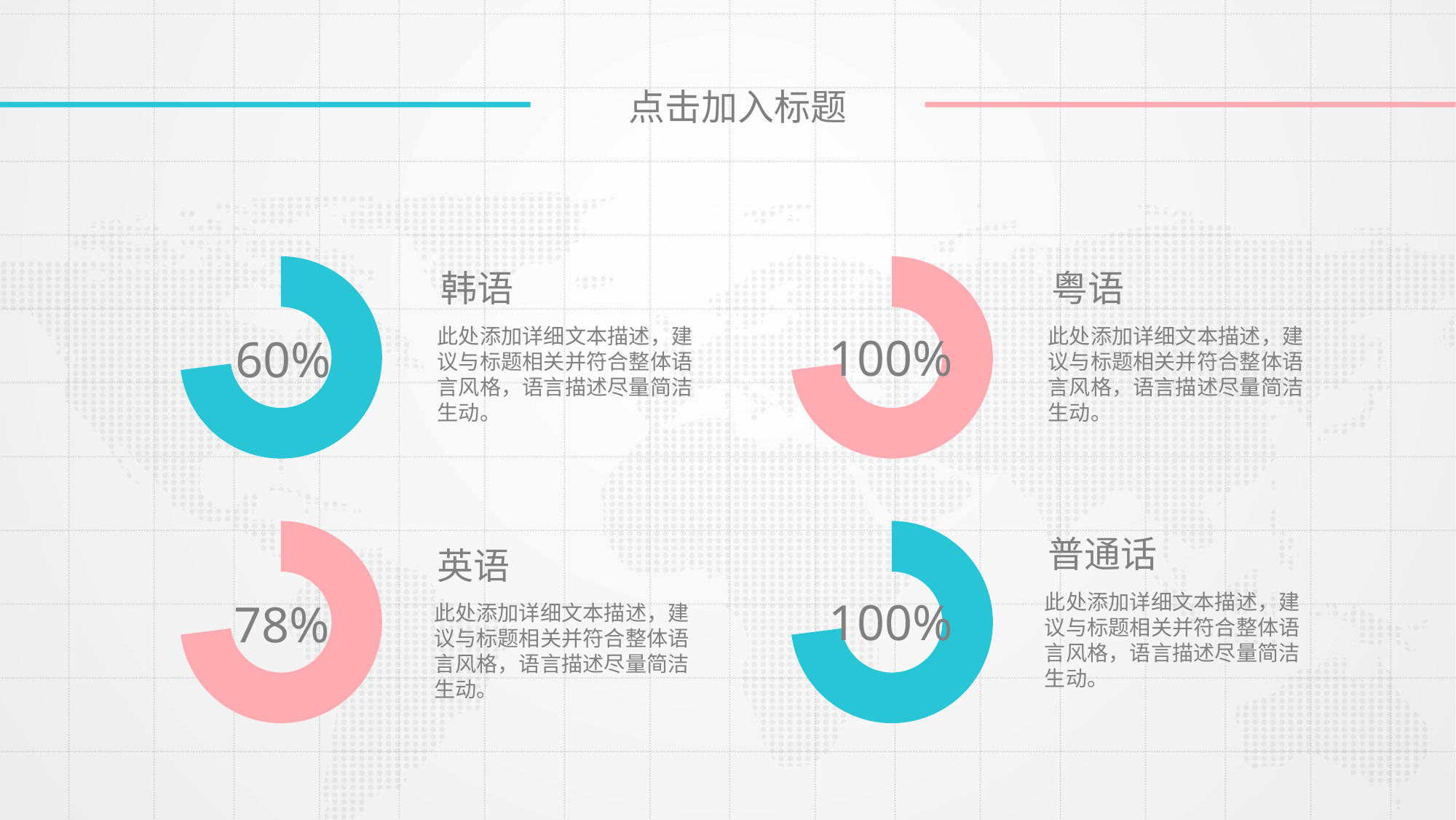
What colour is the ring chart for 英语? Pink What percentage is shown for 普通话? 100% What is the difference between the percentages for 粤语 and 英语? 22% What kind of chart is used for each language on the slide? Donut (ring) chart How many ring charts are on the slide? 4 What percentage is shown for 英语? 78% What percentage is shown for 粤语? 100% How many languages show a value of 100%? 2 Which is larger, the percentage for 英语 or the percentage for 韩语? 英语 Which language has the lowest percentage on the slide? 韩语 What is the difference between the percentages for 英语 and 韩语? 18% What percentage is shown for 韩语? 60%